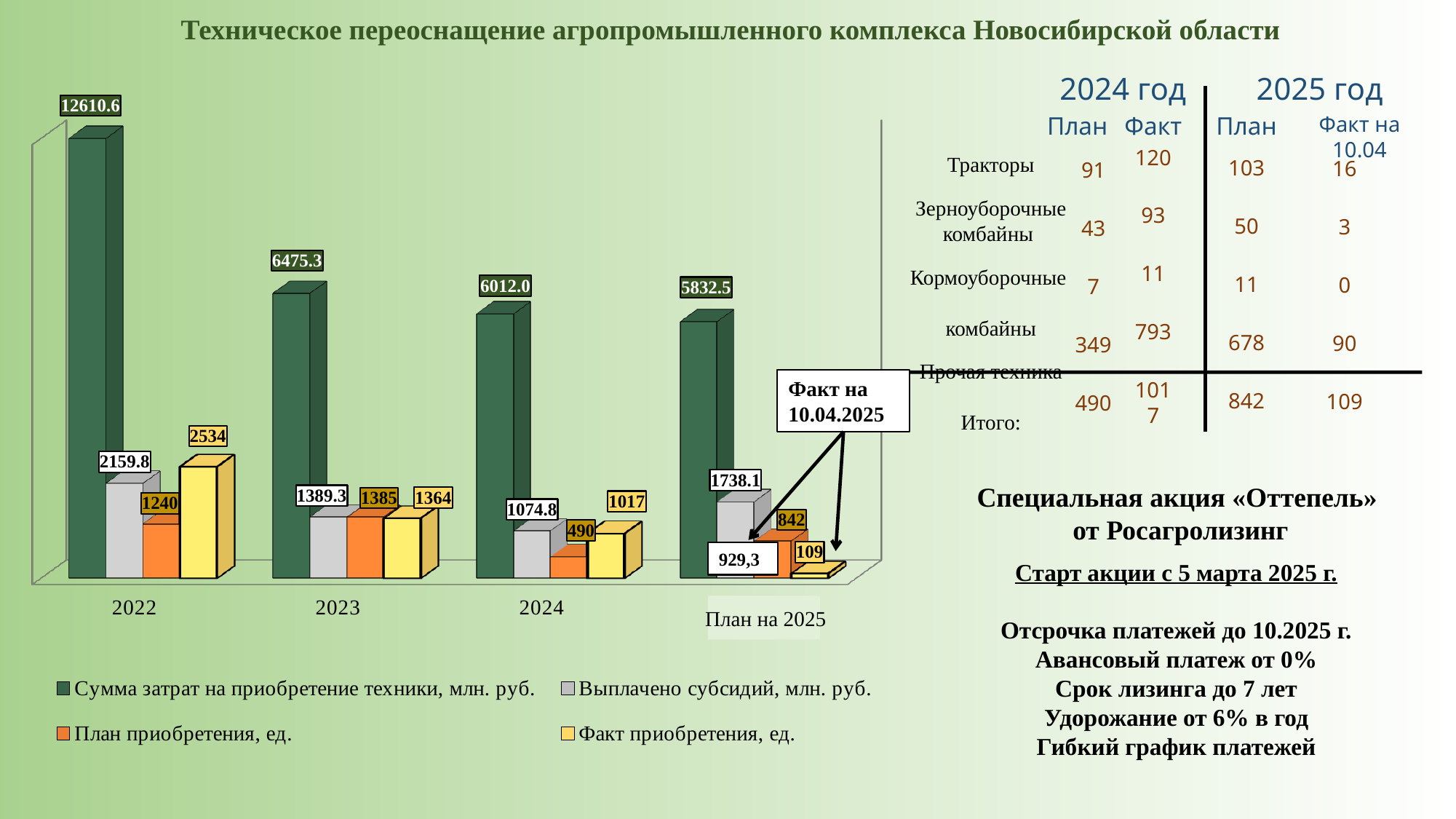
Which category has the lowest value of 'Факт приобретения, ед.'? План на 2025 What is the value of 'Сумма затрат на приобретение техники, млн. руб.' for 2022? 12610.6 Which year has the highest value of 'Сумма затрат на приобретение техники, млн. руб.'? 2022 What is the value of 'План приобретения, ед.' for 'План на 2025'? 842 How many series does the chart legend list? 4 What is the difference between 'Сумма затрат на приобретение техники, млн. руб.' in 2023 and in 2024? 463.3 What kind of chart is shown on the slide? Bar chart What is the value of 'Выплачено субсидий, млн. руб.' for 2023? 1389.3 What is the value of 'Факт приобретения, ед.' for 2024? 1017 Which is larger in 2022: 'План приобретения, ед.' or 'Факт приобретения, ед.'? Факт приобретения, ед. Does 'Сумма затрат на приобретение техники, млн. руб.' rise or fall from 2022 to 'План на 2025'? Fall How many categories are shown on the x axis of the chart? 4